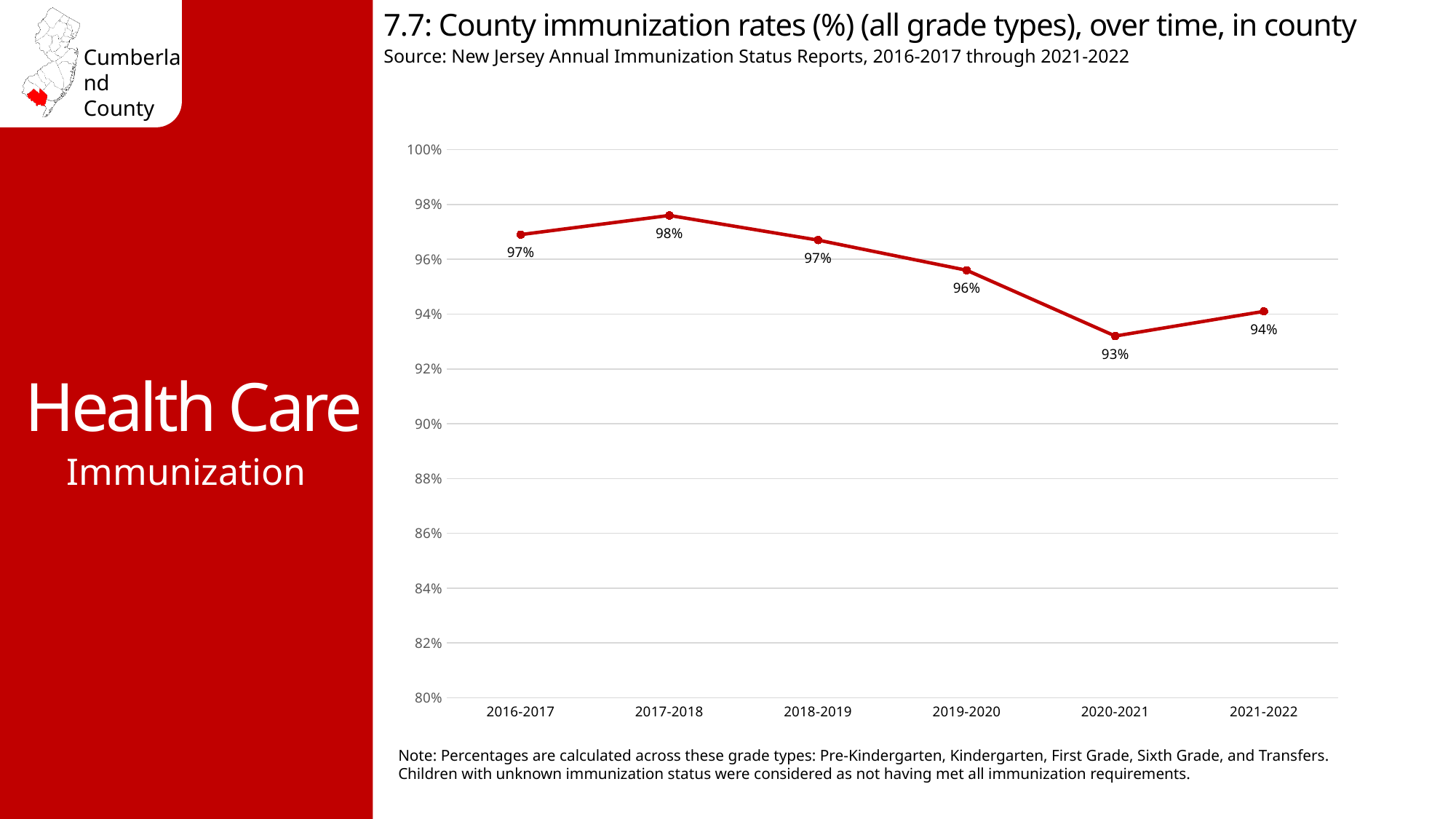
How many school years are plotted on the chart? 6 Which school year had the lowest immunization rate? 2020-2021 What was the county immunization rate in 2021-2022? 94% Which school year had the highest immunization rate? 2017-2018 What kind of chart is shown on the slide? line chart What is the overall trend in immunization rates from 2017-2018 to 2020-2021? falling Is the immunization rate for 2020-2021 greater or less than 94%? less What is the difference in immunization rate between 2017-2018 and 2020-2021? 5% What was the county immunization rate in 2020-2021? 93% Which year had a higher immunization rate, 2019-2020 or 2021-2022? 2019-2020 What was the county immunization rate in 2019-2020? 96% What was the county immunization rate in 2017-2018? 98%